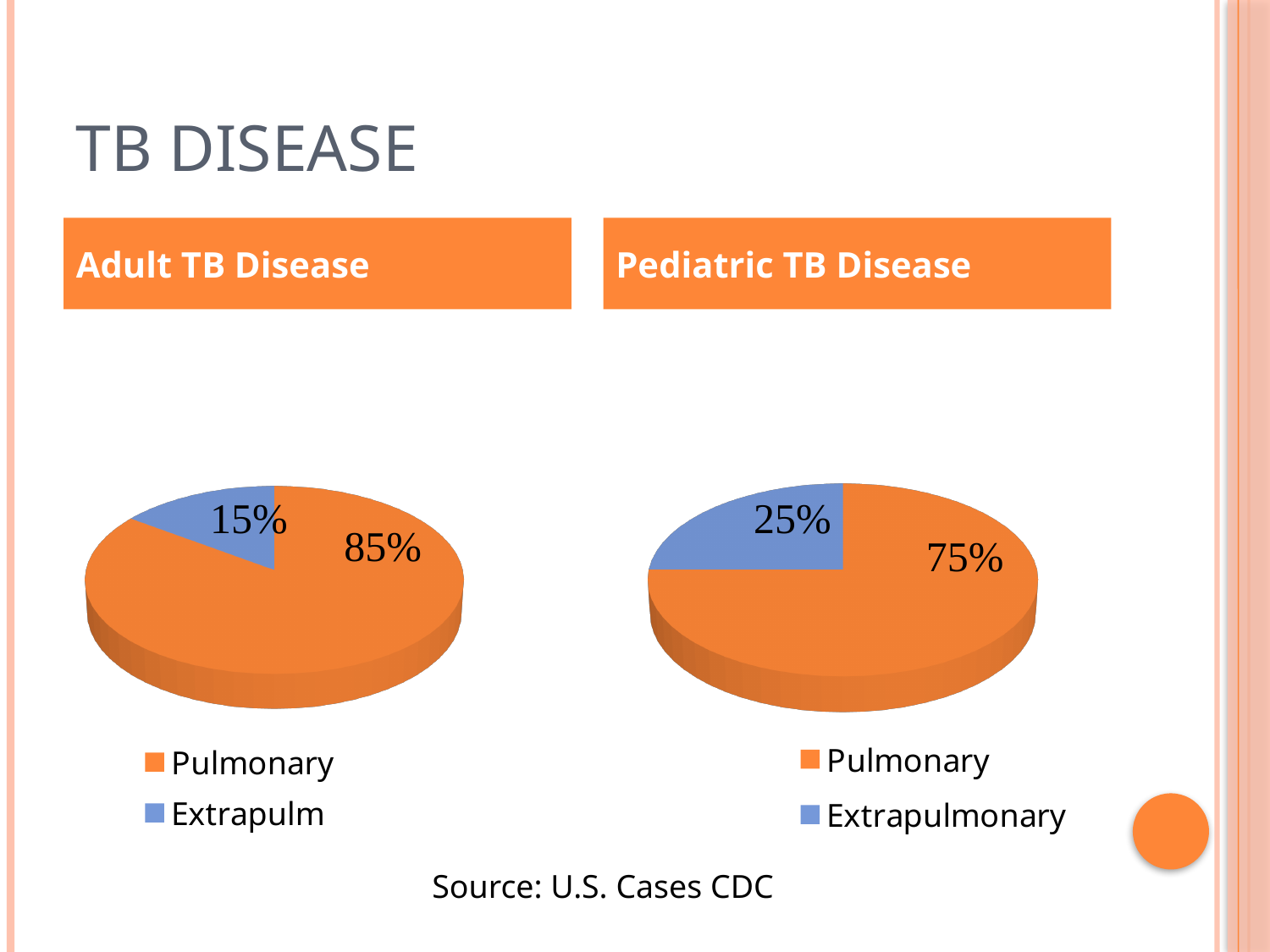
In the Pediatric TB Disease chart, what percentage is Pulmonary? 75% In the Pediatric TB Disease chart, which slice is the smallest? Extrapulmonary In the Adult TB Disease chart, what is the difference between the Pulmonary and Extrapulm shares? 70% In the Adult TB Disease chart, what percentage is Extrapulm? 15% In the Pediatric TB Disease chart, what colour is the Extrapulmonary slice? Blue In the Pediatric TB Disease chart, what percentage is Extrapulmonary? 25% How many slices does the Pediatric TB Disease chart have? 2 Which is larger: the Extrapulm share in the Adult TB Disease chart or the Extrapulmonary share in the Pediatric TB Disease chart? Pediatric TB Disease Extrapulmonary In the Adult TB Disease chart, what percentage is Pulmonary? 85% What type of chart is used for Adult TB Disease? Pie chart In the Adult TB Disease chart, which slice is the largest? Pulmonary How many entries does the legend of the Adult TB Disease chart list? 2